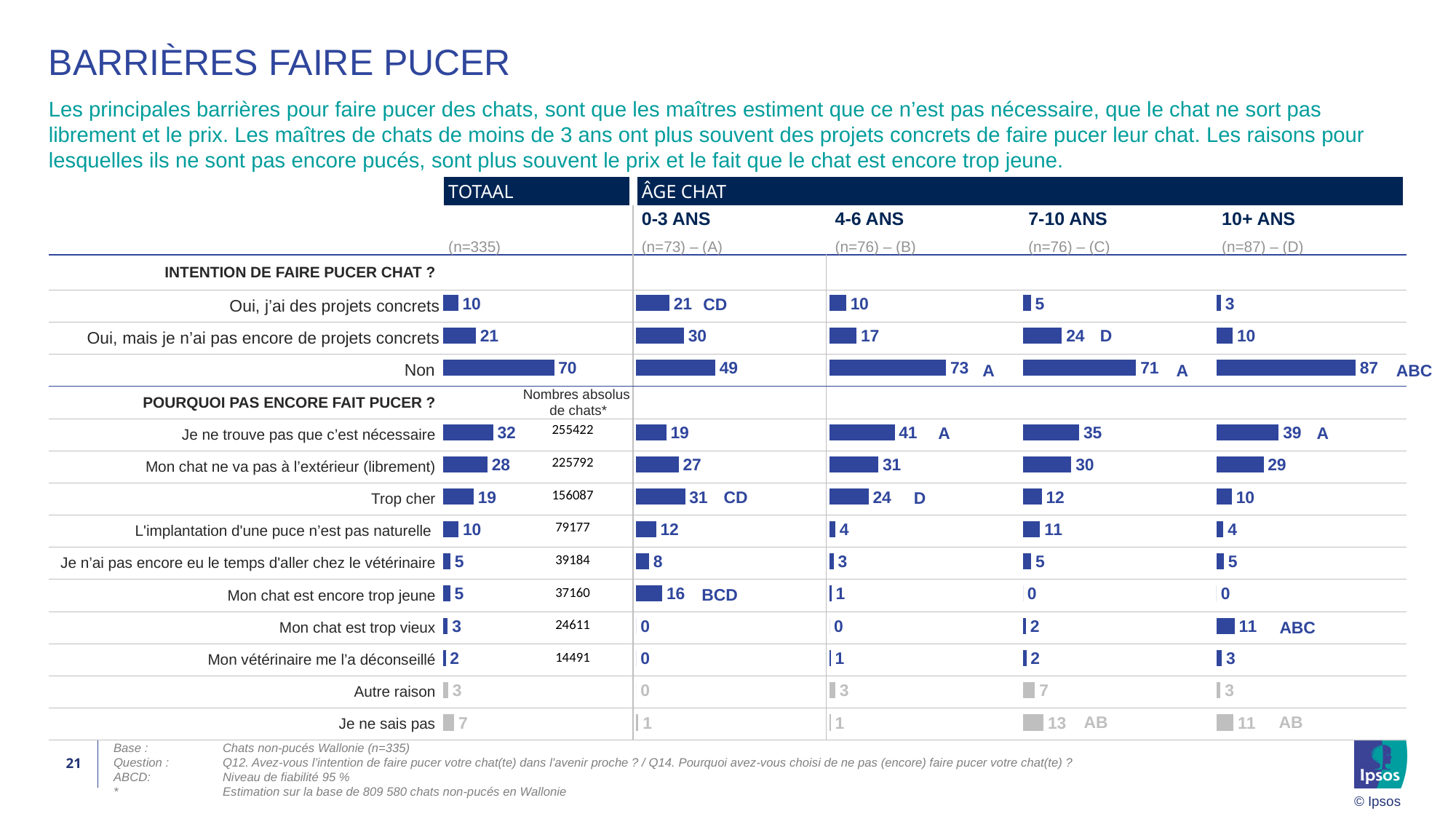
In the TOTAAL column, what is the value for "Non" under "Intention de faire pucer chat ?"? 70 In the 10+ ANS column, what is the value for "Mon chat est trop vieux"? 11 How many reasons are listed under "Pourquoi pas encore fait pucer ?"? 10 In the 10+ ANS column, what is the value for "Non"? 87 In the 0-3 ANS column, what is the value for "Oui, j'ai des projets concrets"? 21 In the TOTAAL column, which reason under "Pourquoi pas encore fait pucer ?" has the highest value? Je ne trouve pas que c'est nécessaire What kind of chart is used to display the values in the table? Bar chart What is the absolute number of cats (Nombres absolus de chats) shown for "Mon chat ne va pas à l'extérieur (librement)"? 225792 What is the difference between the "Trop cher" values for 0-3 ANS and 10+ ANS? 21 Across the four age columns, which age group has the lowest value for "Non"? 0-3 ANS Which is larger: the "Mon chat est encore trop jeune" value for 0-3 ANS or for 4-6 ANS? 0-3 ANS In the 4-6 ANS column, what is the value for "Je ne trouve pas que c'est nécessaire"? 41